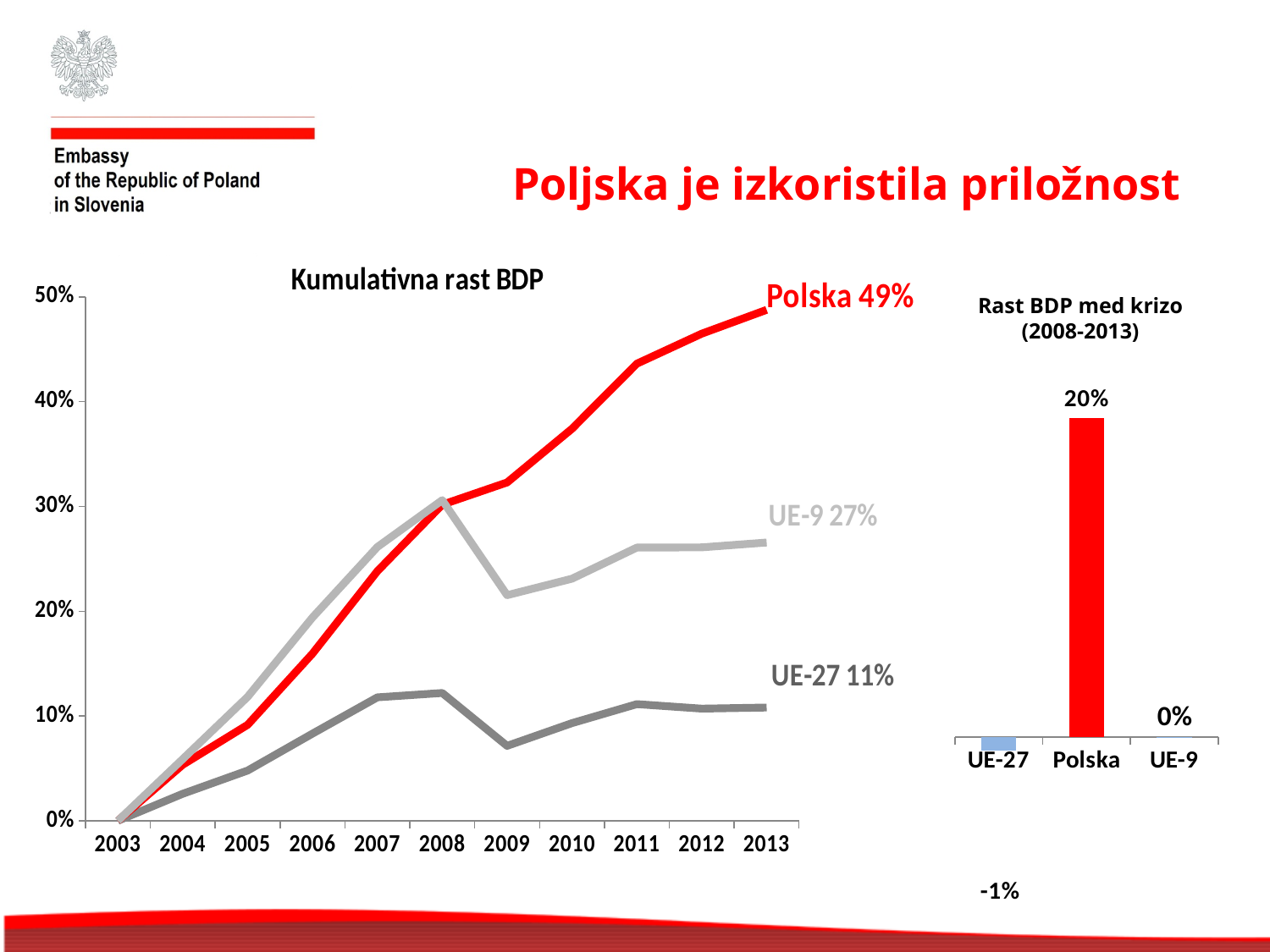
In the 'Rast BDP med krizo (2008-2013)' chart, what is the value for UE-27? -1% In the 'Kumulativna rast BDP' chart, what is the final value shown for UE-27? 11% In the 'Kumulativna rast BDP' chart, is the value for Polska in 2011 greater or less than 40%? greater In the 'Rast BDP med krizo (2008-2013)' chart, what is the value for Polska? 20% What kind of chart is 'Kumulativna rast BDP'? line chart In the 'Kumulativna rast BDP' chart, how many years are shown on the x axis? 11 In the 'Kumulativna rast BDP' chart, which series ends with the highest cumulative growth? Polska In the 'Rast BDP med krizo (2008-2013)' chart, which category has the lowest value? UE-27 In the 'Kumulativna rast BDP' chart, what is the final value shown for UE-9? 27% What kind of chart is 'Rast BDP med krizo (2008-2013)'? bar chart In the 'Kumulativna rast BDP' chart, what is the final value shown for Polska? 49% In the 'Kumulativna rast BDP' chart, what is the difference between the final values of Polska and UE-27? 38%